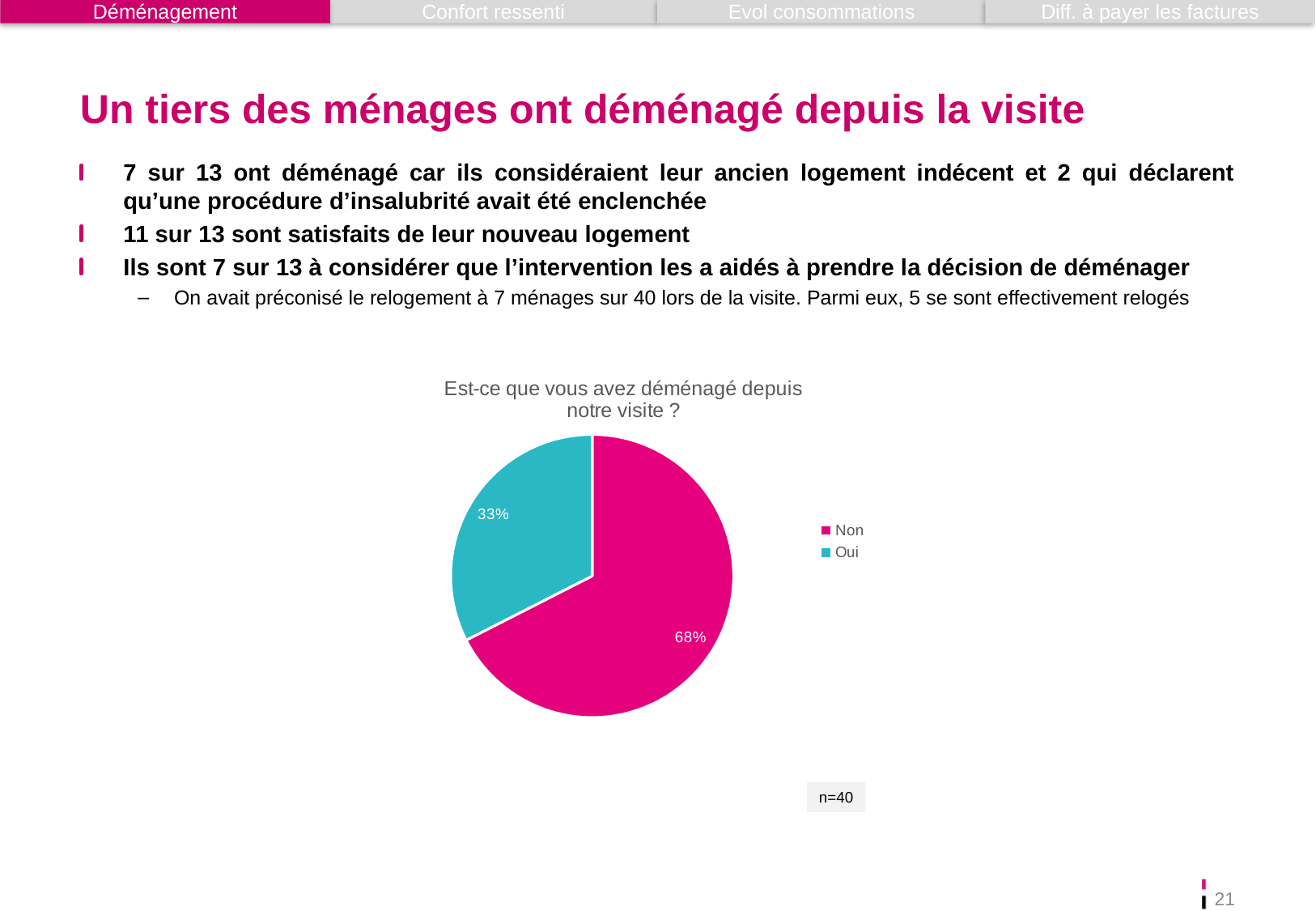
How many entries does the legend of the pie chart list? 2 What is the value for "Oui" in the pie chart? 33% Which is larger in the pie chart, "Oui" or "Non"? Non What colour is the "Oui" slice in the pie chart? teal (cyan) How many slices does the pie chart have? 2 What is the title of the pie chart? Est-ce que vous avez déménagé depuis notre visite ? What sample size is indicated below the pie chart? n=40 What is the value for "Non" in the pie chart? 68% What kind of chart is shown on the slide? pie chart Which category has the smallest share of the pie chart? Oui What is the difference between the "Non" and "Oui" shares in the pie chart? 35% Which category has the largest share of the pie chart? Non